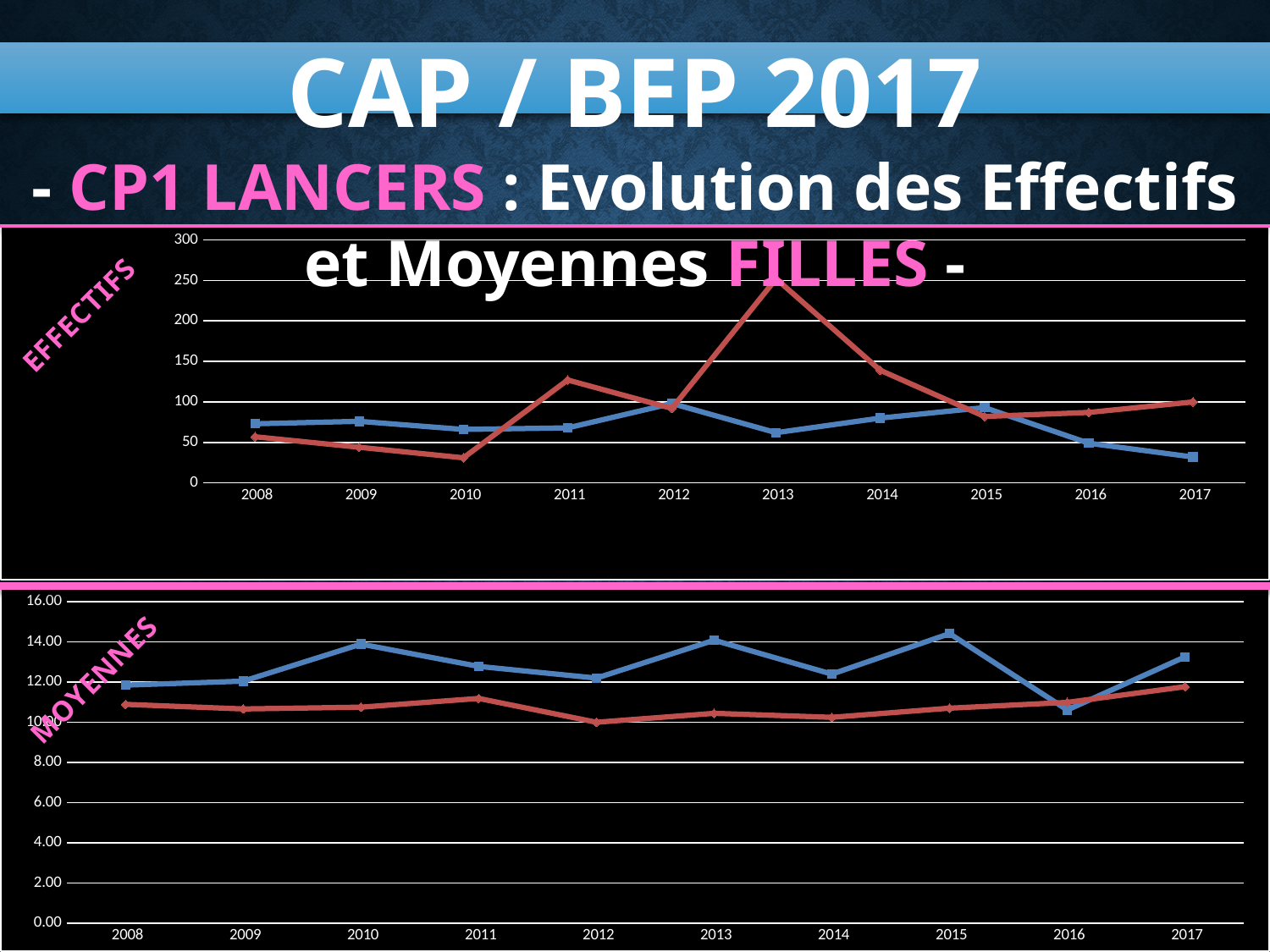
In the top chart labelled EFFECTIFS, in which year does the blue line reach its lowest value? 2017 In the bottom chart labelled MOYENNES, does the blue line rise or fall from 2015 to 2016? fall In the top chart labelled EFFECTIFS, is the value of the red line in 2013 greater or less than 200? greater In the top chart labelled EFFECTIFS, is the value of the blue line in 2017 greater or less than 50? less In the bottom chart labelled MOYENNES, in which year does the blue line reach its lowest value? 2016 In the top chart labelled EFFECTIFS, which line has the larger value in 2013, the red line or the blue line? the red line How many years are shown on the x axis of the top chart labelled EFFECTIFS? 10 In the bottom chart labelled MOYENNES, is the value of the blue line in 2010 greater or less than 12.00? greater In the top chart labelled EFFECTIFS, in which year does the red line reach its highest value? 2013 In the bottom chart labelled MOYENNES, which line has the larger value in 2010, the blue line or the red line? the blue line What kind of chart is the top chart labelled EFFECTIFS? line chart In the top chart labelled EFFECTIFS, does the blue line rise or fall from 2015 to 2017? fall